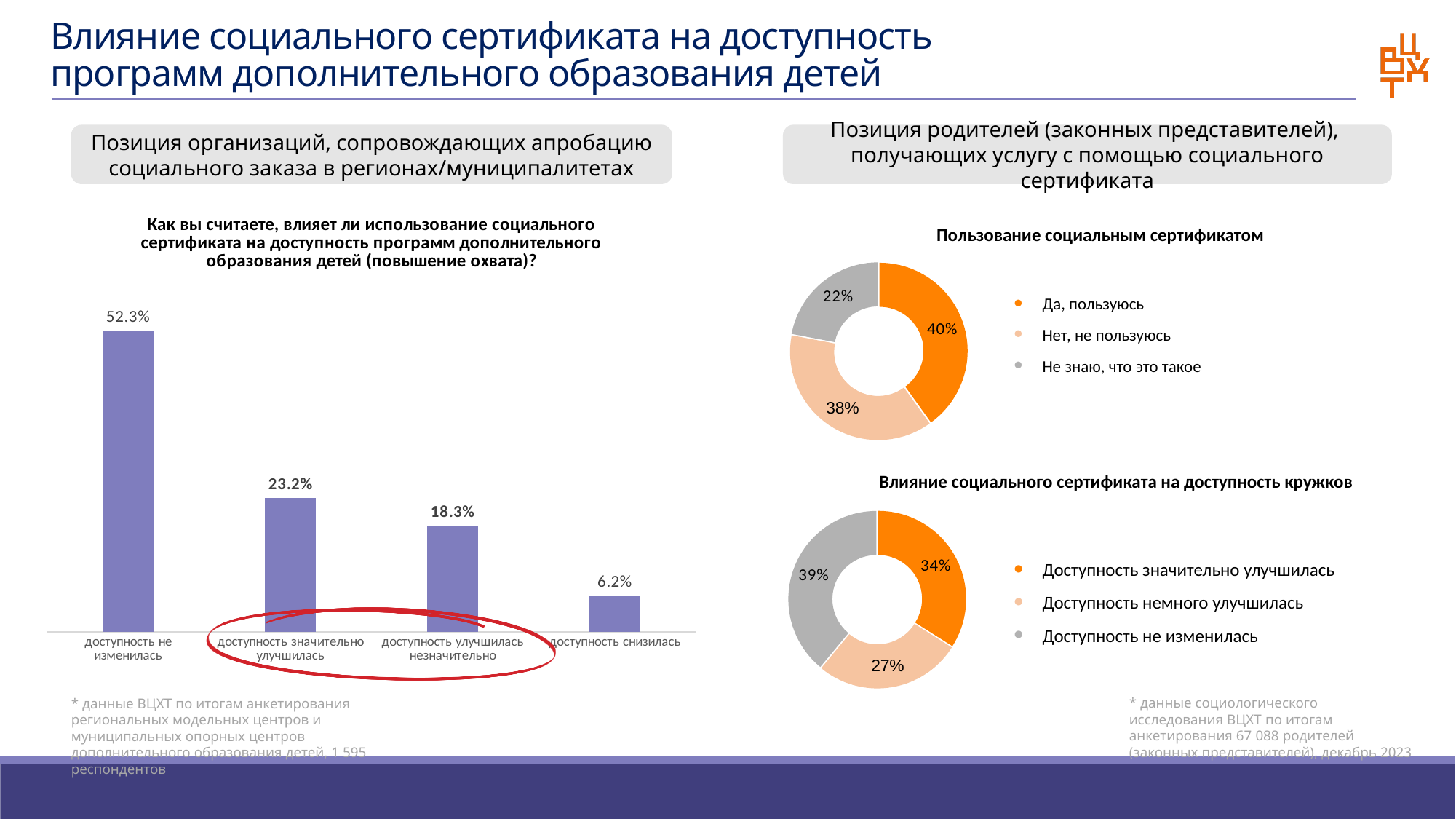
In the chart «Влияние социального сертификата на доступность кружков», how many categories does the legend list? 3 In the bar chart on the left, what is the difference between «доступность значительно улучшилась» and «доступность улучшилась незначительно»? 4.9% In the chart «Влияние социального сертификата на доступность кружков», what is the value for «Доступность немного улучшилась»? 27% In the chart «Пользование социальным сертификатом», what is the value for «Не знаю, что это такое»? 22% What type of chart is the chart on the left of the slide? bar chart In the bar chart on the left, how many categories are shown? 4 In the chart «Влияние социального сертификата на доступность кружков», which category has the largest share? Доступность не изменилась In the bar chart on the left, what is the value for «доступность не изменилась»? 52.3% In the bar chart on the left, which category has the lowest value? доступность снизилась In the bar chart on the left, which category has the highest value? доступность не изменилась In the chart «Пользование социальным сертификатом», what share of respondents answered «Да, пользуюсь»? 40% In the bar chart on the left, what is the value for «доступность снизилась»? 6.2%